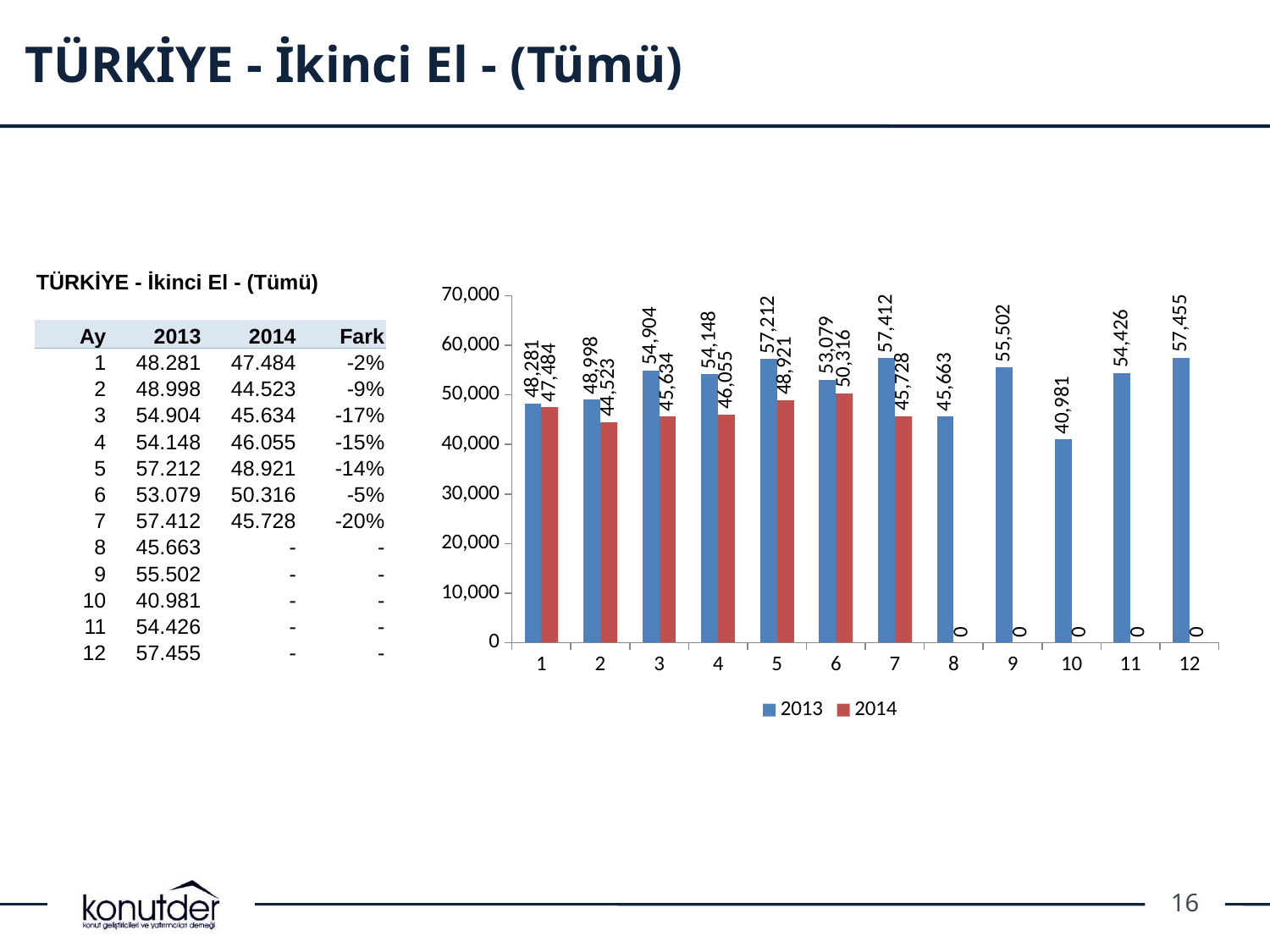
How many series does the chart legend list? 2 Which is larger for month 6: the 2013 value or the 2014 value? 2013 Do the 2014 values rise or fall from month 2 to month 6? rise How many months are shown on the x axis of the chart? 12 What is the difference between the 2013 and 2014 values for month 7? 11,684 Which month has the highest 2014 value in the chart? 6 What kind of chart is shown on the slide? bar chart Is the 2013 value for month 10 greater or less than 50,000? less What is the 2014 value shown for month 9 in the chart? 0 What is the 2014 value for month 5 in the chart? 48,921 Which month has the lowest 2013 value in the chart? 10 What is the 2013 value for month 3 in the chart? 54,904